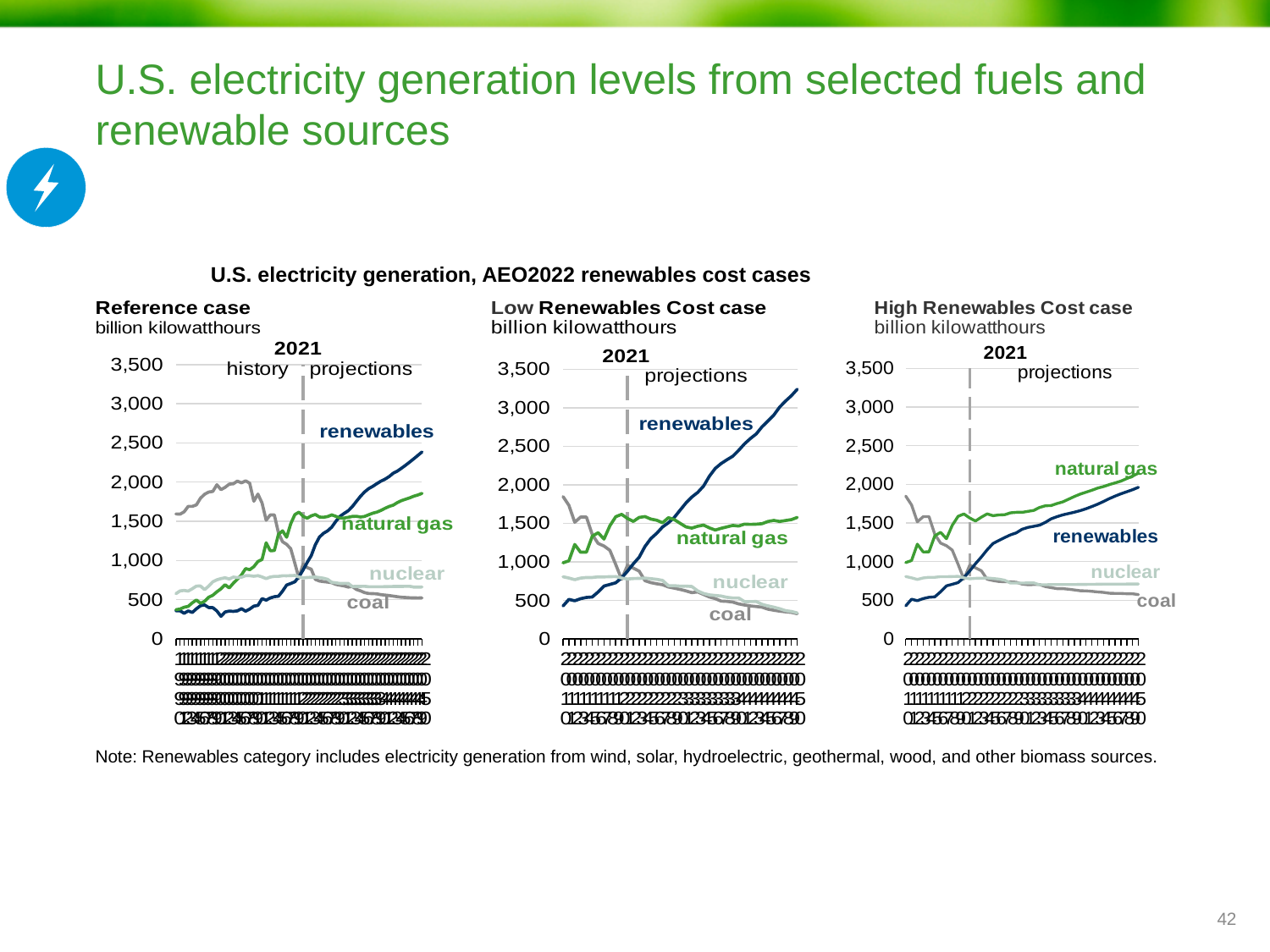
What kind of chart is the Reference case chart? line chart In the High Renewables Cost case chart, is the final projected value for natural gas greater or less than 2,000? greater In the High Renewables Cost case chart, which series has the highest value at the end of the projection period? natural gas In the Reference case chart, is the final projected value for renewables greater or less than 2,000? greater In the Reference case chart, is the final projected value for coal greater or less than 1,000? less In the Low Renewables Cost case chart, at the end of the projection period, which is larger: renewables or natural gas? renewables In the Reference case chart, does the renewables series rise or fall over the projection period? rise What unit is used on the y axis of the three charts? billion kilowatthours How many fuel series are labeled in the Low Renewables Cost case chart? 4 How many charts are shown on the slide? 3